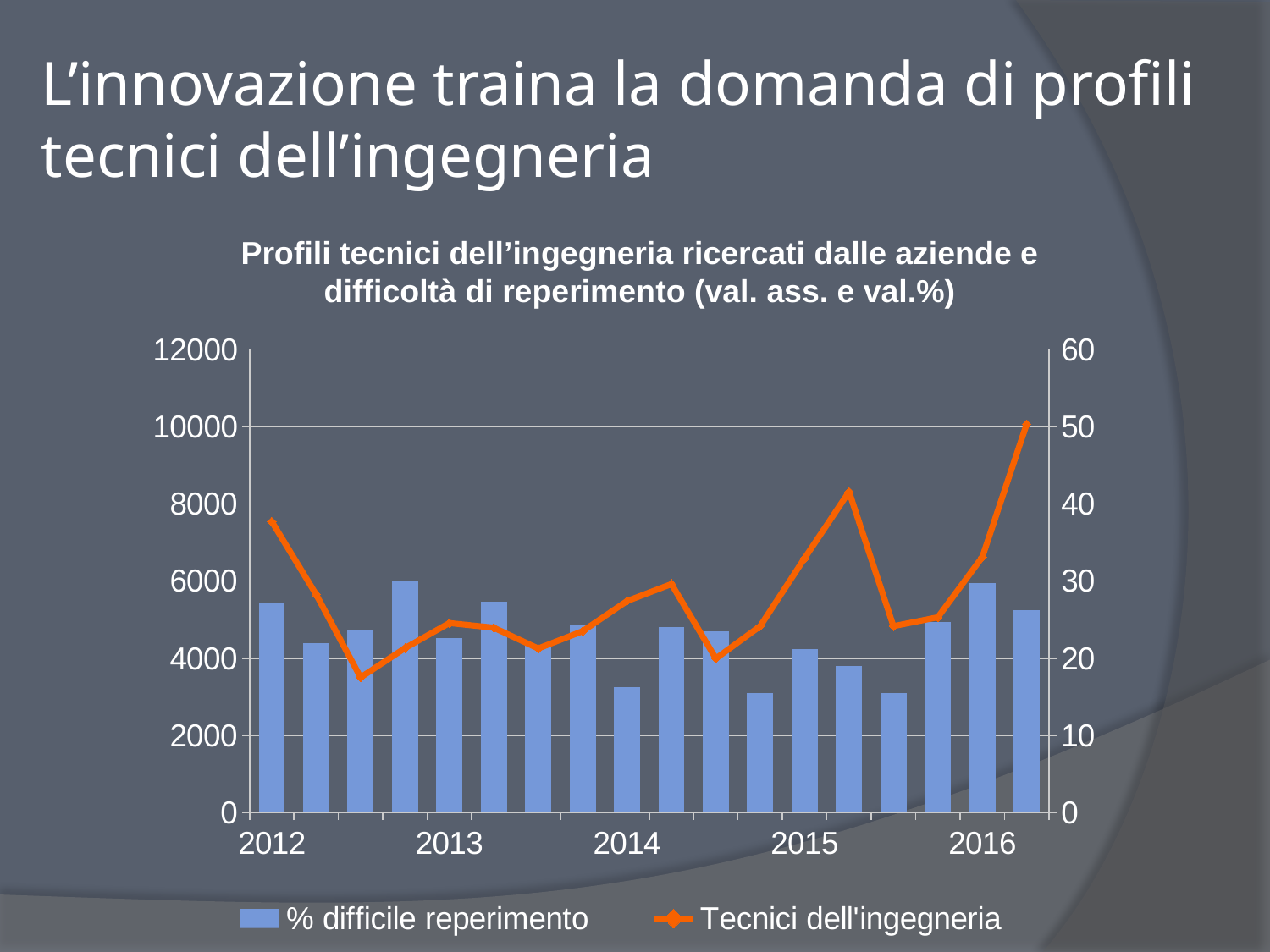
How many series does the legend list? 2 Is the point of the Tecnici dell'ingegneria line at the 2016 label greater or less than 30 on the right axis? greater How many years are labelled on the x axis? 5 What is the title of the chart? Profili tecnici dell'ingegneria ricercati dalle aziende e difficoltà di reperimento (val. ass. e val.%) Does the Tecnici dell'ingegneria line end higher or lower than it starts? Higher Which of the two bars is taller: the bar at the 2012 label or the bar at the 2014 label? The bar at the 2012 label Is the first point of the Tecnici dell'ingegneria line (at 2012) greater or less than 30 on the right axis? greater What are the two series named in the legend? % difficile reperimento and Tecnici dell'ingegneria What kind of chart is shown on the slide? A combined bar and line chart Is the value of the bar at the 2014 label greater or less than 4000 on the left axis? less At which point does the Tecnici dell'ingegneria line reach its highest value? The last point, after the 2016 label